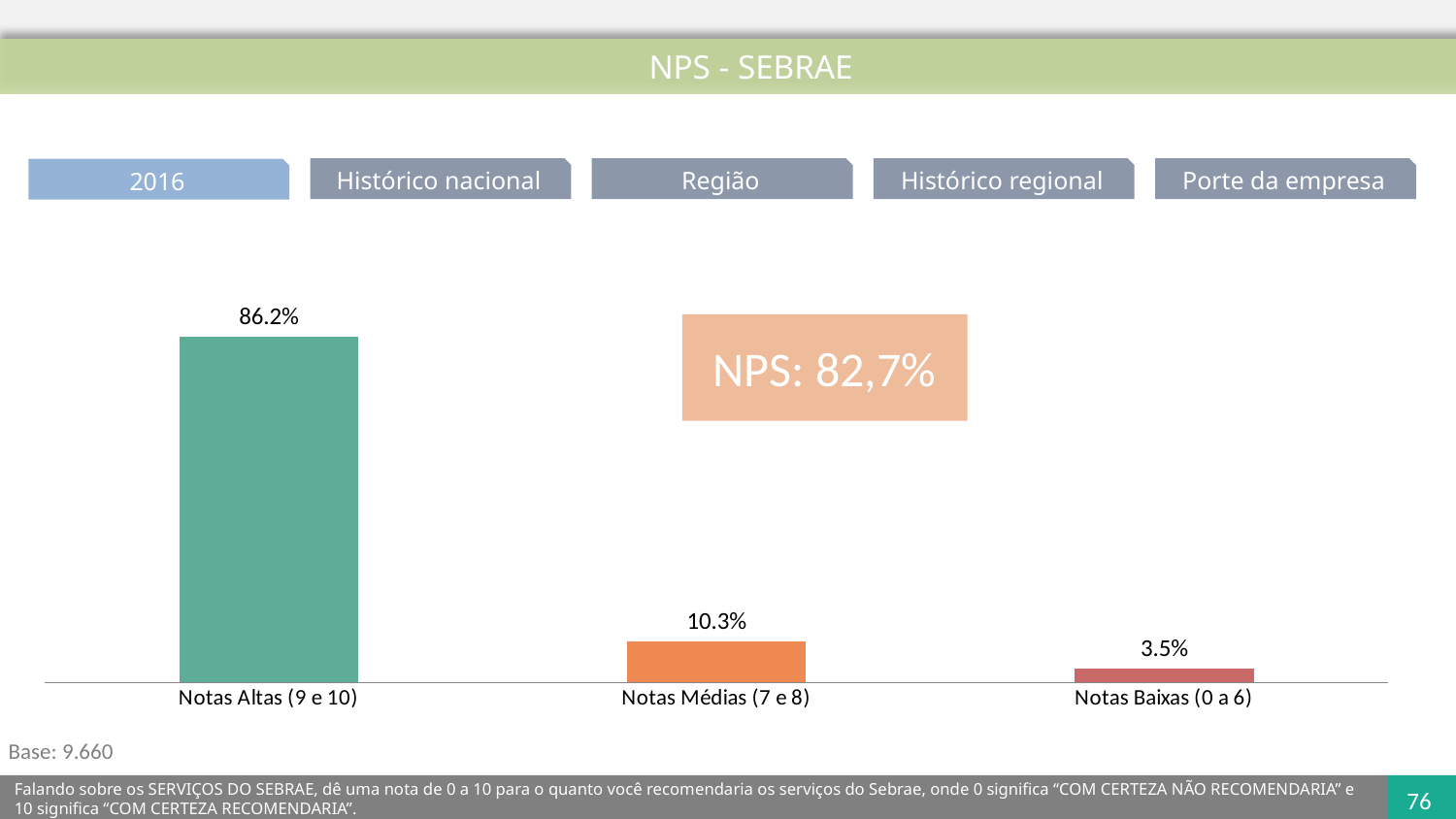
What is the difference between the values for Notas Médias (7 e 8) and Notas Baixas (0 a 6)? 6.8 percentage points Which is larger, the value for Notas Médias (7 e 8) or Notas Baixas (0 a 6)? Notas Médias (7 e 8) What is the value for Notas Altas (9 e 10)? 86.2% Do the values rise or fall from left to right across the categories? Fall Which category has the lowest value? Notas Baixas (0 a 6) What NPS value is shown in the box on the chart? 82,7% What is the value for Notas Baixas (0 a 6)? 3.5% How many categories are shown in the chart? 3 What kind of chart is shown on the slide? Bar chart What is the value for Notas Médias (7 e 8)? 10.3% Which category has the highest value? Notas Altas (9 e 10) What is the difference between the values for Notas Altas (9 e 10) and Notas Médias (7 e 8)? 75.9 percentage points